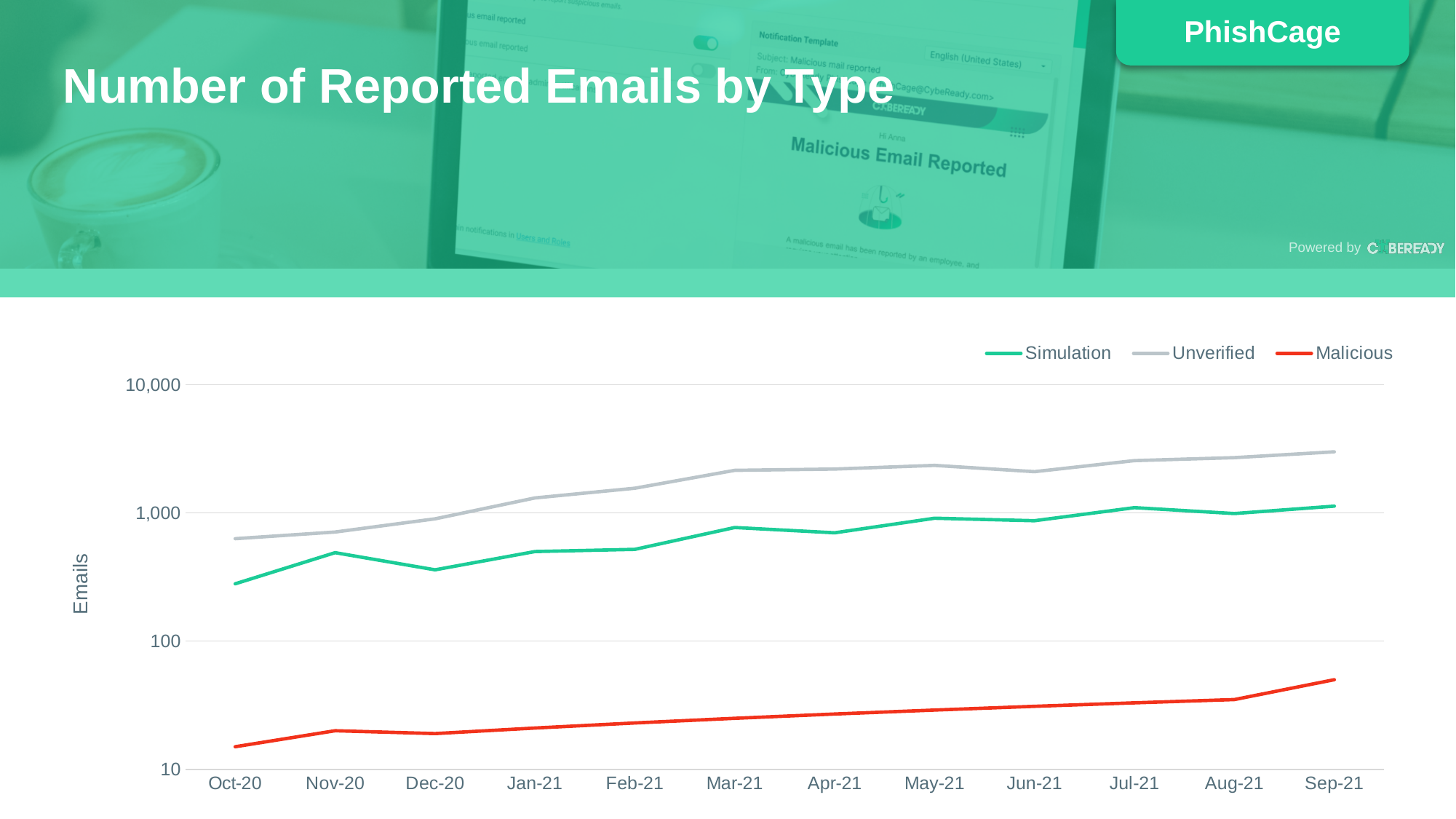
Does the Malicious series generally rise or fall from Oct-20 to Sep-21? rise In which month is the Malicious series at its lowest? Oct-20 How many series does the legend list? 3 In which month is the Unverified series at its highest? Sep-21 Is the value for Simulation in Oct-20 greater or less than 1,000? less Which series has the highest values across all months? Unverified Is the value for Malicious in Sep-21 greater or less than 100? less What is the label on the y axis? Emails How many months are plotted along the x axis? 12 Which series has the lowest values across all months? Malicious What kind of chart is shown on the slide? line chart Is the value for Unverified in Sep-21 greater or less than 1,000? greater